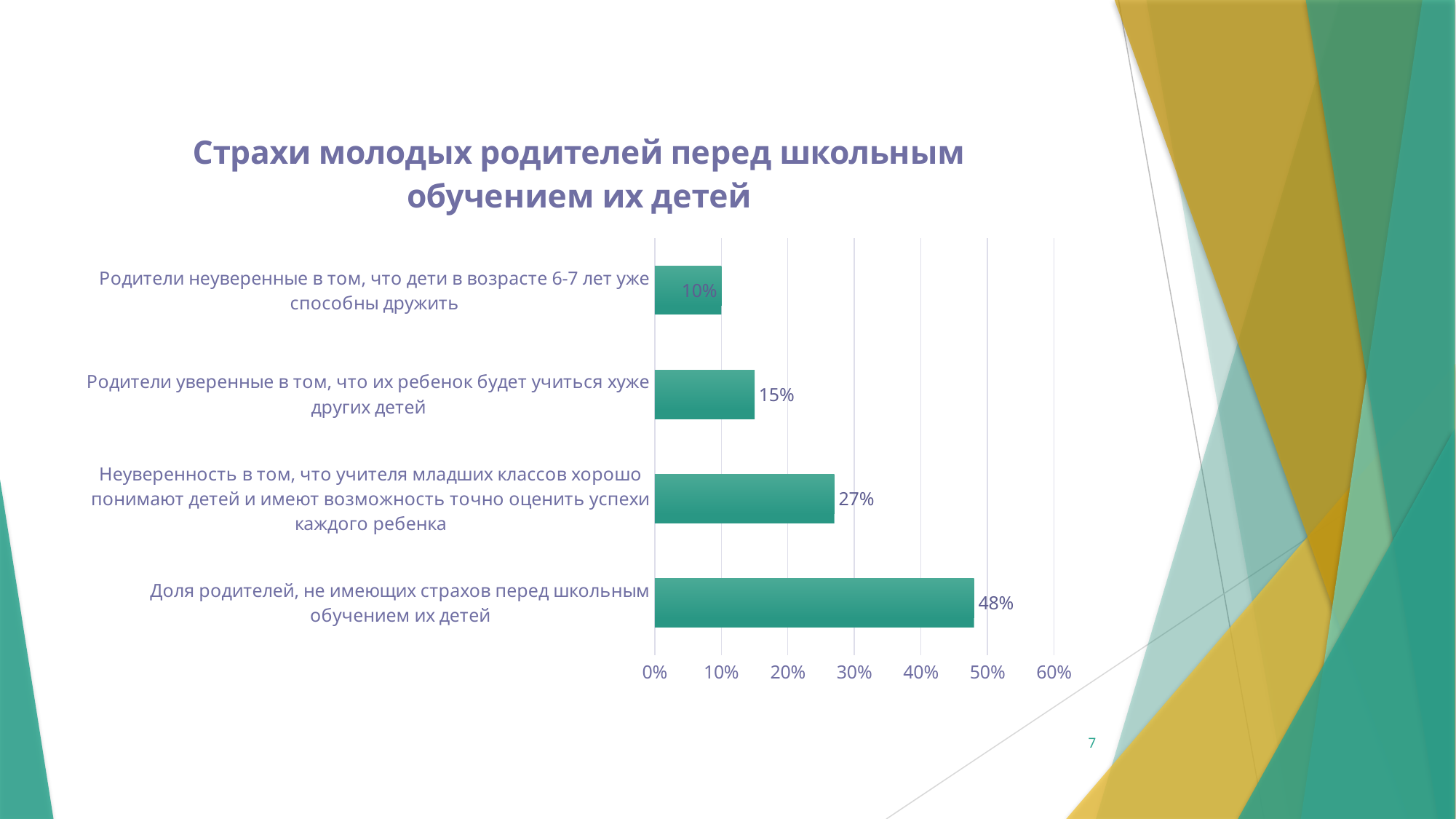
What is the difference between the value for 'Доля родителей, не имеющих страхов перед школьным обучением их детей' and the value for 'Неуверенность в том, что учителя младших классов хорошо понимают детей и имеют возможность точно оценить успехи каждого ребенка'? 21% What is the value for 'Родители уверенные в том, что их ребенок будет учиться хуже других детей'? 15% Which category has the lowest value? Родители неуверенные в том, что дети в возрасте 6-7 лет уже способны дружить What kind of chart is shown on the slide? bar chart What is the title of the chart? Страхи молодых родителей перед школьным обучением их детей What is the value for 'Доля родителей, не имеющих страхов перед школьным обучением их детей'? 48% Which is larger: the value for 'Родители уверенные в том, что их ребенок будет учиться хуже других детей' or the value for 'Родители неуверенные в том, что дети в возрасте 6-7 лет уже способны дружить'? Родители уверенные в том, что их ребенок будет учиться хуже других детей What is the value for 'Родители неуверенные в том, что дети в возрасте 6-7 лет уже способны дружить'? 10% How many categories are shown in the chart? 4 Is the value for 'Неуверенность в том, что учителя младших классов хорошо понимают детей и имеют возможность точно оценить успехи каждого ребенка' greater or less than 20%? greater What is the value for 'Неуверенность в том, что учителя младших классов хорошо понимают детей и имеют возможность точно оценить успехи каждого ребенка'? 27% Which category has the highest value? Доля родителей, не имеющих страхов перед школьным обучением их детей